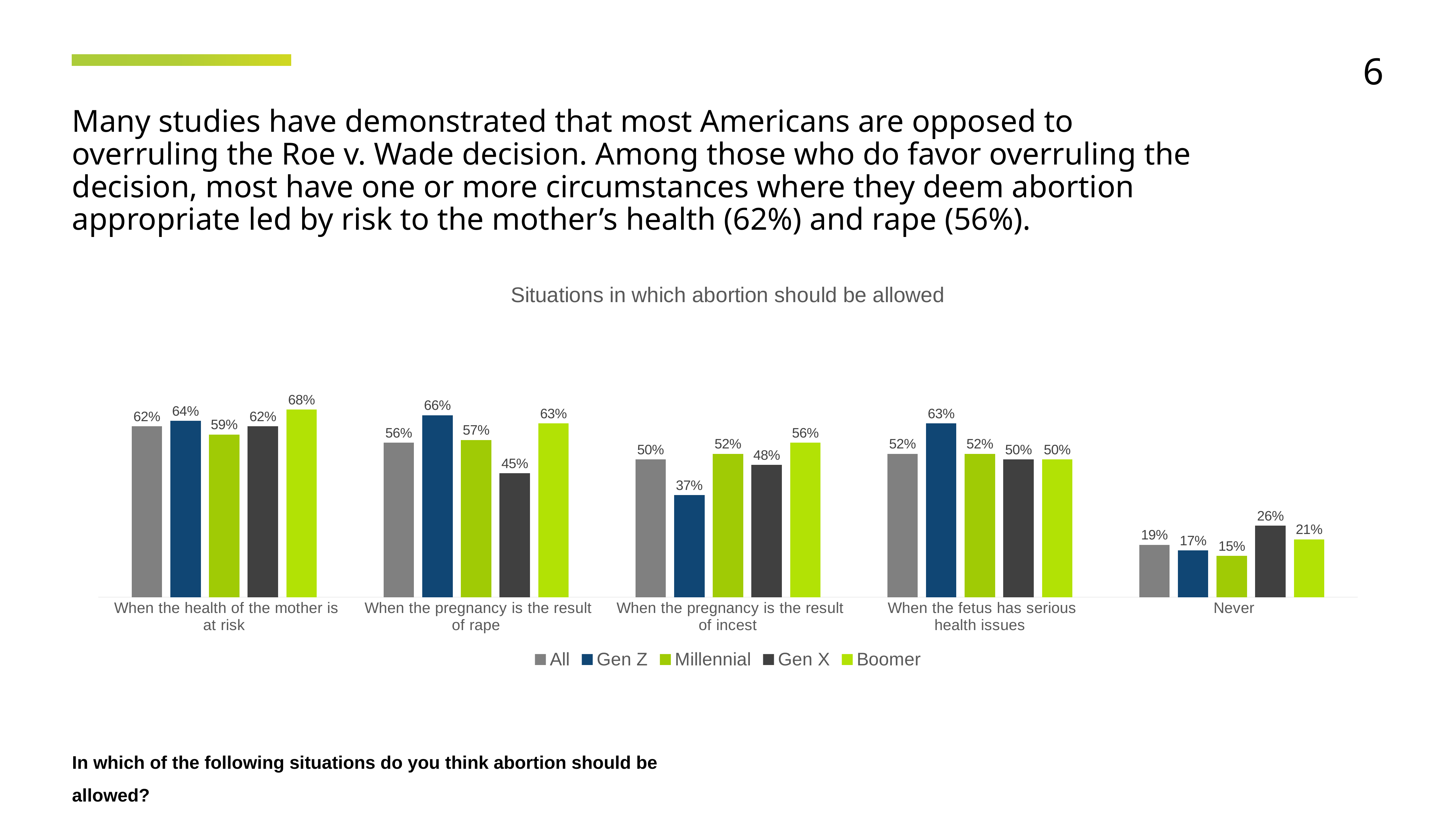
What kind of chart is shown on the slide? Bar chart What is the difference between the Gen Z and Gen X values for "When the pregnancy is the result of rape"? 21% What is the "All" value for "When the pregnancy is the result of incest"? 50% Which is larger for "When the fetus has serious health issues": the Gen Z value or the Millennial value? Gen Z How many situation categories are shown on the x axis? 5 What is the Gen X value for "Never"? 26% How many series does the legend list? 5 What is the title of the chart? Situations in which abortion should be allowed What is the Boomer value for "When the health of the mother is at risk"? 68% What is the Gen Z value for "When the pregnancy is the result of incest"? 37% Which series has the highest value for "When the pregnancy is the result of rape"? Gen Z Which series has the lowest value for "Never"? Millennial